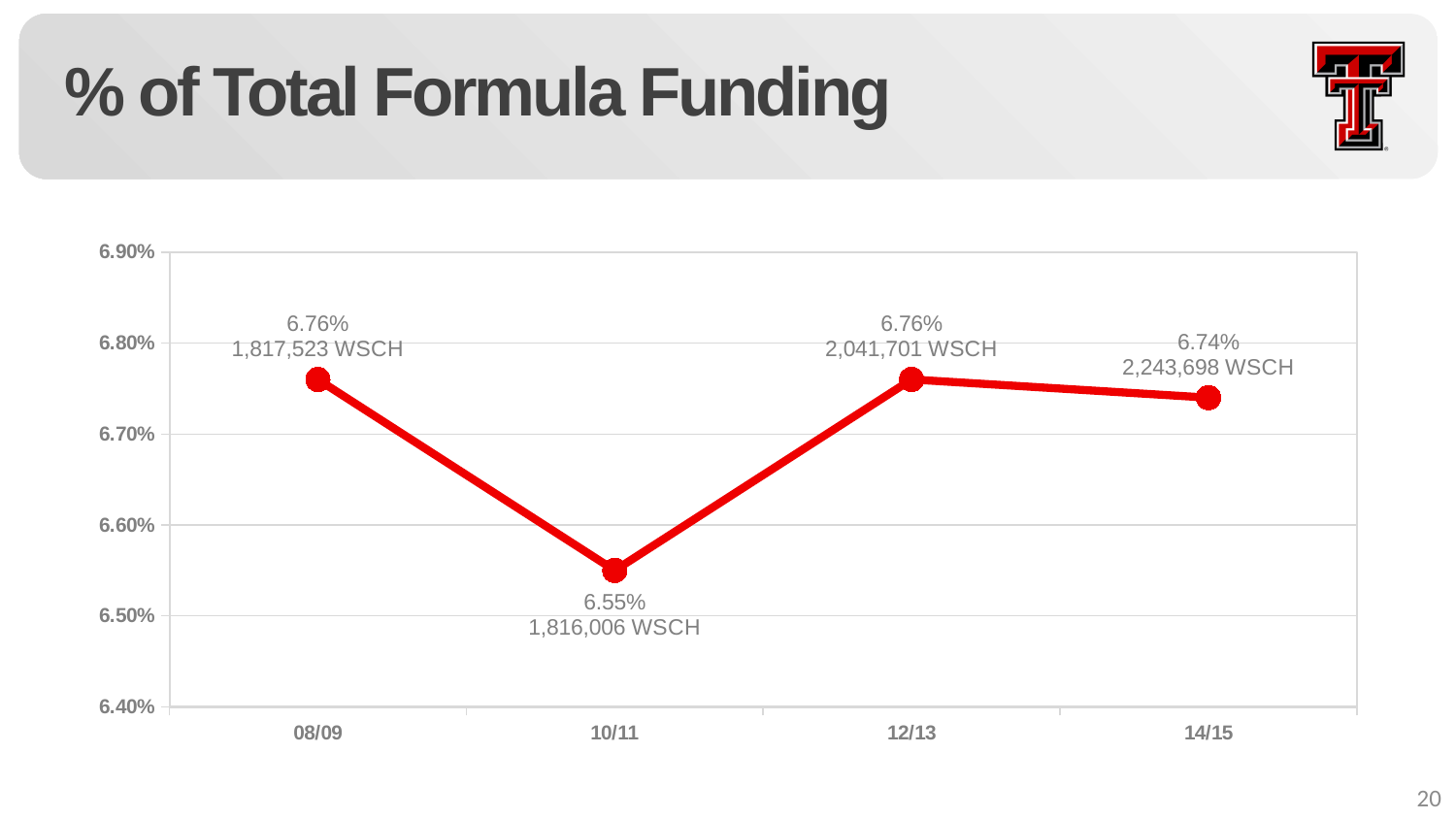
How many WSCH are shown for 10/11? 1,816,006 WSCH Does the % of total formula funding rise or fall from 10/11 to 12/13? rise What is the % of total formula funding for 10/11? 6.55% Which period has the lowest % of total formula funding? 10/11 What is the difference in % of total formula funding between 12/13 and 10/11? 0.21% Is the value for 10/11 greater or less than 6.60%? less What kind of chart is shown on the slide? line chart What is the % of total formula funding for 14/15? 6.74% What is the % of total formula funding for 08/09? 6.76% Which is larger, the % of total formula funding for 12/13 or for 14/15? 12/13 How many WSCH are shown for 12/13? 2,041,701 WSCH How many data points are plotted on the chart? 4